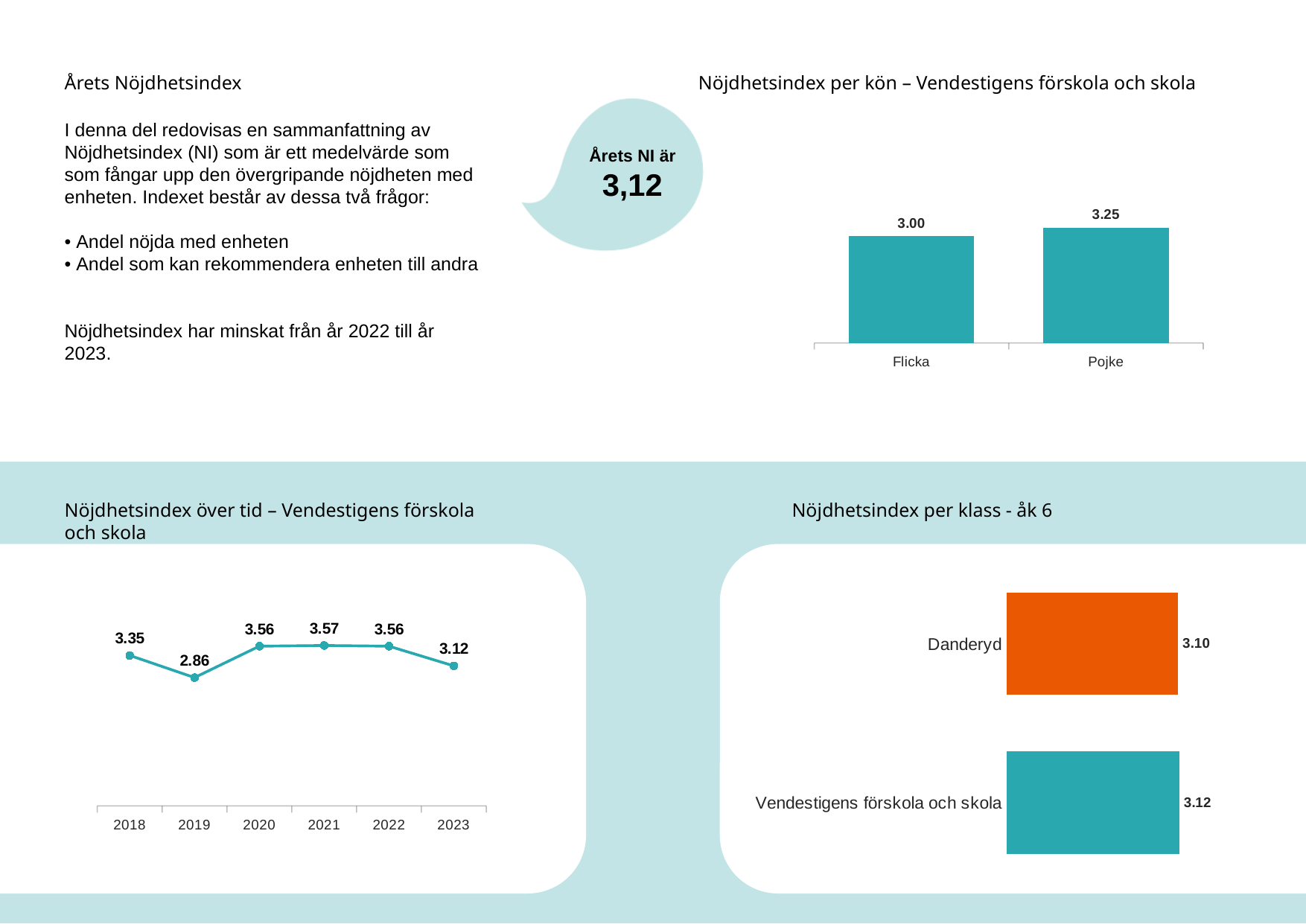
In the 'Nöjdhetsindex över tid' chart, what is the value for 2019? 2.86 In the 'Nöjdhetsindex per kön' chart, what is the difference between Pojke and Flicka? 0.25 In the 'Nöjdhetsindex över tid' chart, which year has the highest value? 2021 In the 'Nöjdhetsindex över tid' chart, which year has the lowest value? 2019 In the 'Nöjdhetsindex per klass - åk 6' chart, what is the value for Danderyd? 3.10 In the 'Nöjdhetsindex per kön' chart, what is the value for Flicka? 3.00 What kind of chart is 'Nöjdhetsindex över tid – Vendestigens förskola och skola'? Line chart In the 'Nöjdhetsindex per kön' chart, what is the value for Pojke? 3.25 In the 'Nöjdhetsindex per kön' chart, which category has the higher value? Pojke In the 'Nöjdhetsindex per klass - åk 6' chart, which is larger: Danderyd or Vendestigens förskola och skola? Vendestigens förskola och skola In the 'Nöjdhetsindex över tid' chart, did the value rise or fall from 2022 to 2023? Fall In the 'Nöjdhetsindex över tid' chart, how many years are plotted? 6